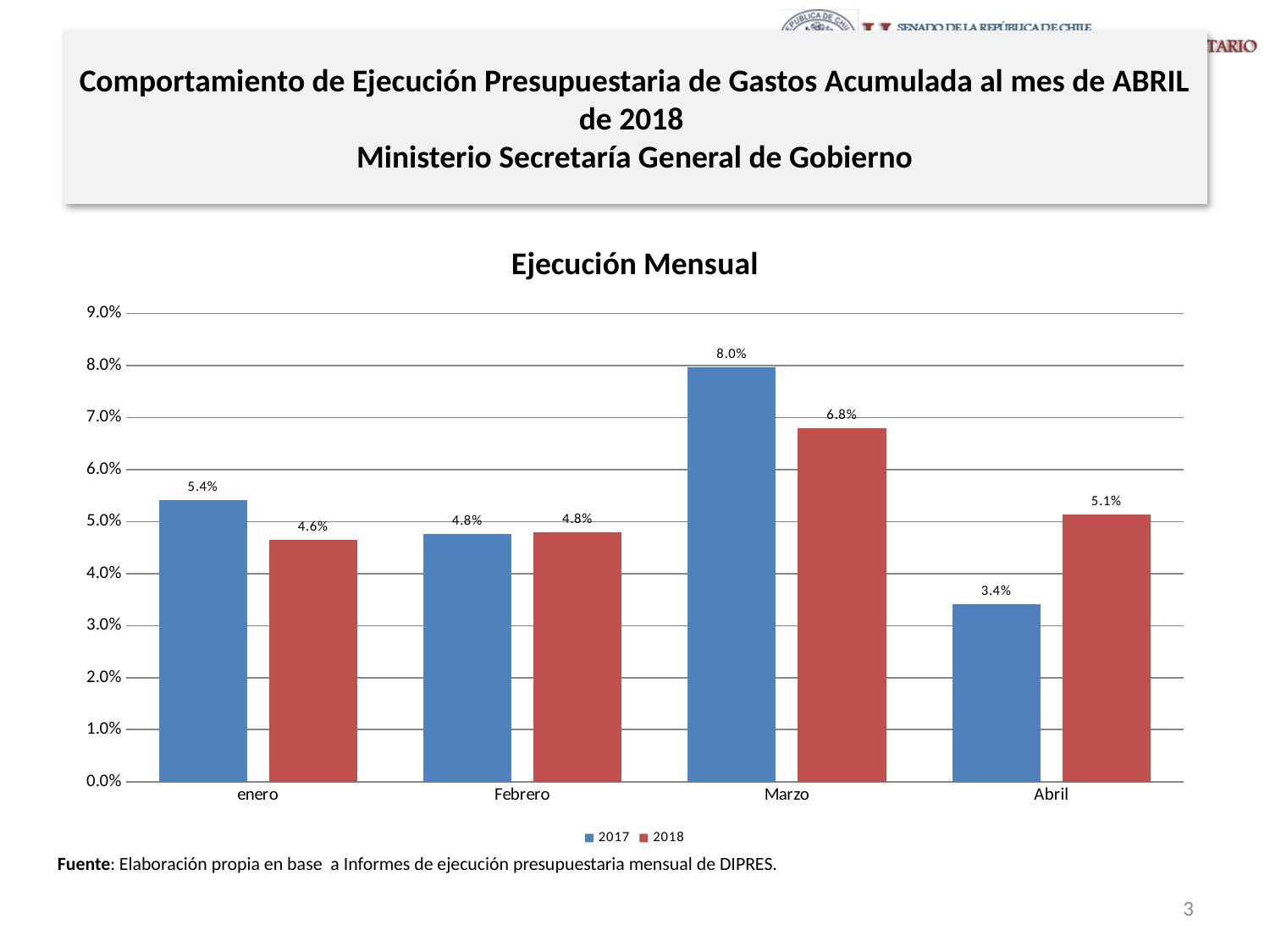
Which is larger in Abril, the 2017 value or the 2018 value? 2018 Which month has the lowest value for the 2018 series? enero What is the value for 2018 in enero? 4.6% What is the difference between the 2017 and 2018 values in Marzo? 1.2% Which month has the highest value for the 2017 series? Marzo How many months are shown on the x axis? 4 Is the value for 2018 in Marzo greater or less than 6.0%? greater What kind of chart is shown? Bar chart What is the value for 2018 in Abril? 5.1% What is the value for 2017 in Marzo? 8.0% How many series does the legend list? 2 Which month has the lowest value for the 2017 series? Abril